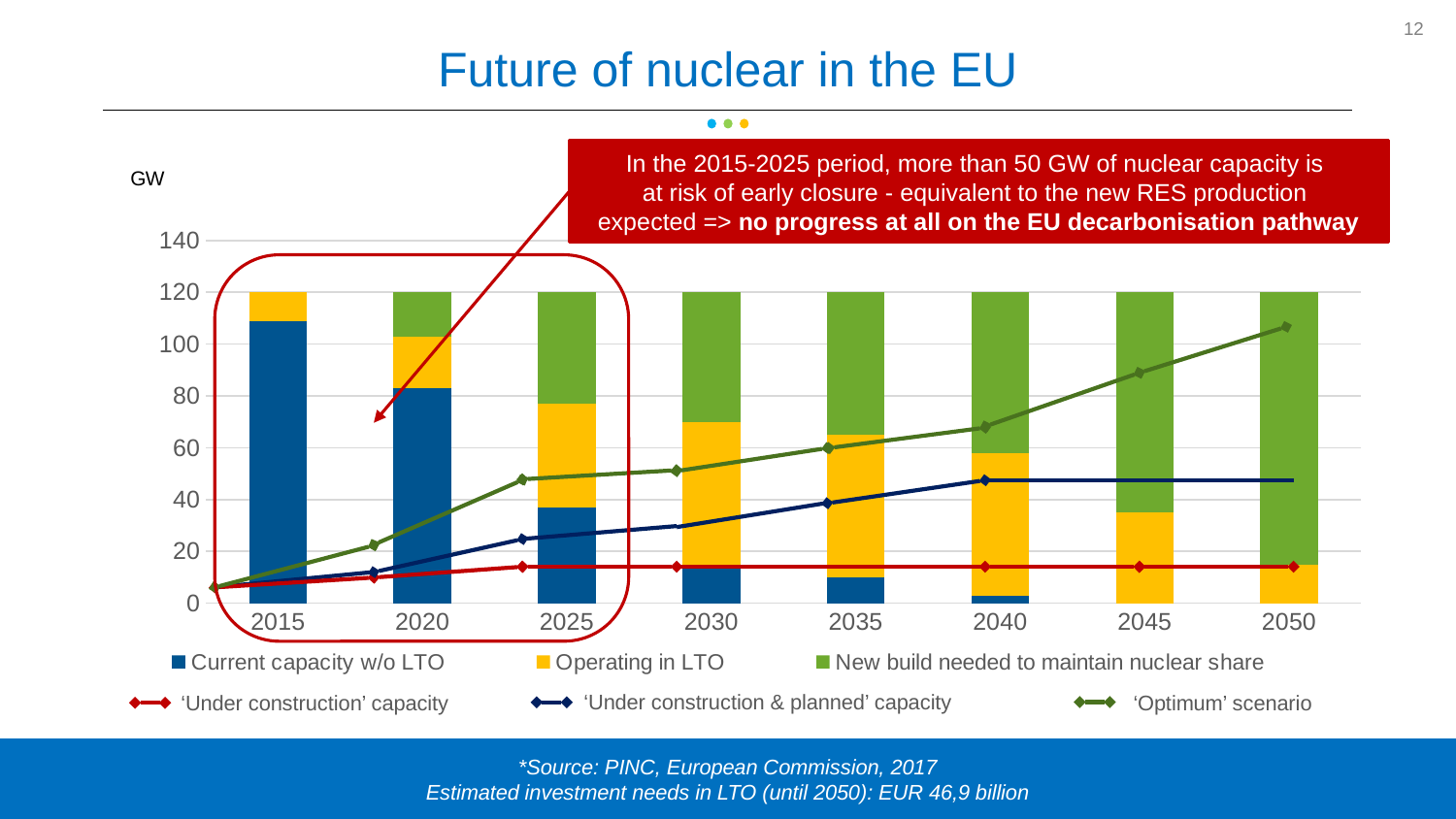
What is the total height of the stacked bar for 2030? 120 Is the value for 'Current capacity w/o LTO' in 2015 greater or less than 100? greater Is the 'Optimum' scenario value in 2050 greater or less than 100? greater What kind of chart is shown on the slide? Stacked bar chart combined with line chart How many years are shown on the x axis of the chart? 8 Which is larger: the 'Optimum' scenario value in 2050 or in 2020? 2050 Does the 'Optimum' scenario line rise or fall from 2015 to 2050? rise How many series does the chart legend list? 6 Which year has the highest 'Current capacity w/o LTO' value? 2015 What unit is shown on the y axis of the chart? GW Is the value for 'Current capacity w/o LTO' in 2025 greater or less than 60? less